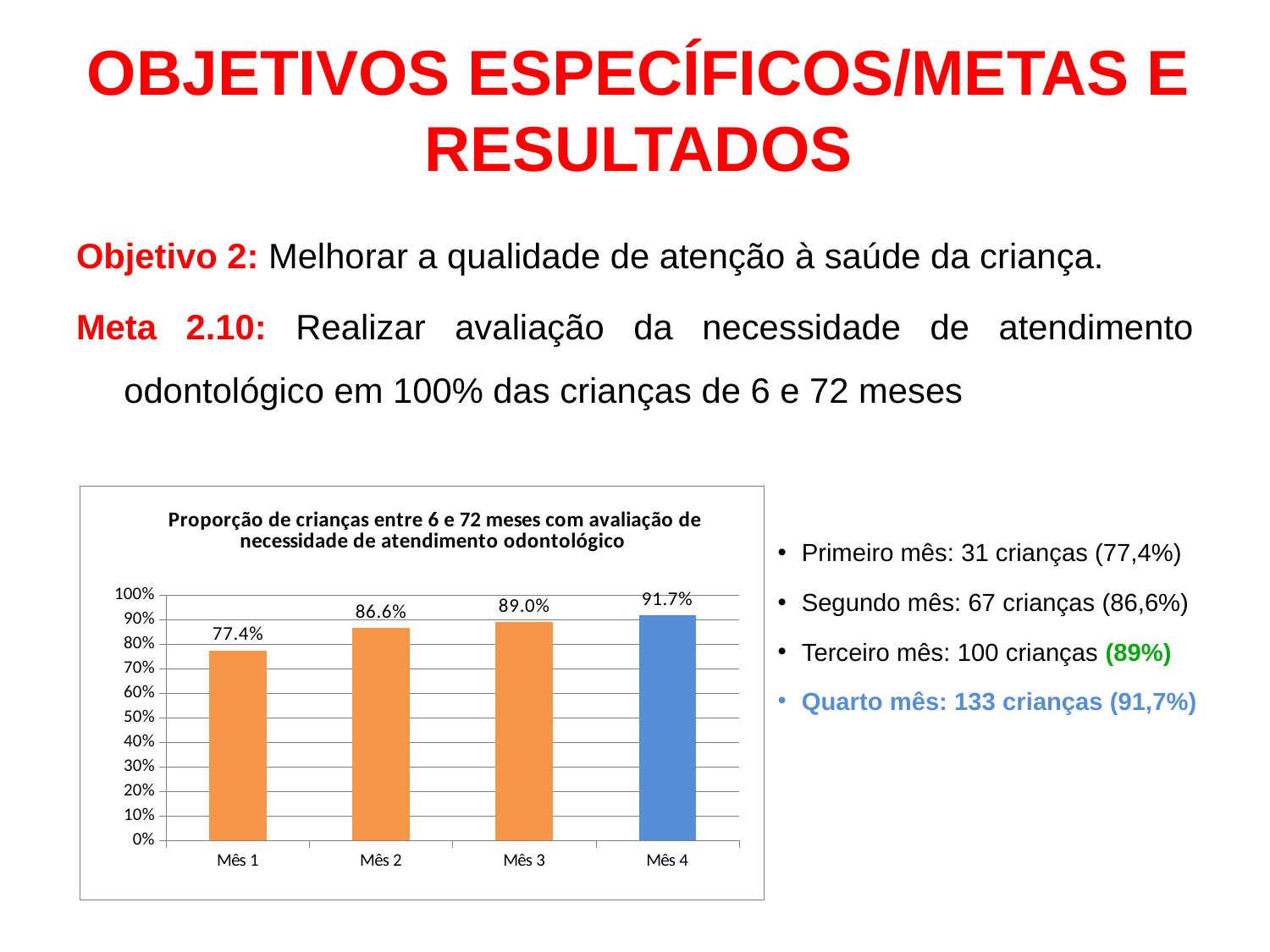
Which month has the lowest value? Mês 1 What is the value for Mês 4? 91.7% What is the value for Mês 3? 89.0% What kind of chart is shown? bar chart Is the value for Mês 1 greater or less than 80%? less How many months are shown on the x axis? 4 Which is larger, the value for Mês 2 or the value for Mês 3? Mês 3 Which month has the highest value? Mês 4 What is the difference between the values for Mês 4 and Mês 1? 14.3% What is the value for Mês 1? 77.4% Do the values rise or fall from Mês 1 to Mês 4? rise What is the value for Mês 2? 86.6%